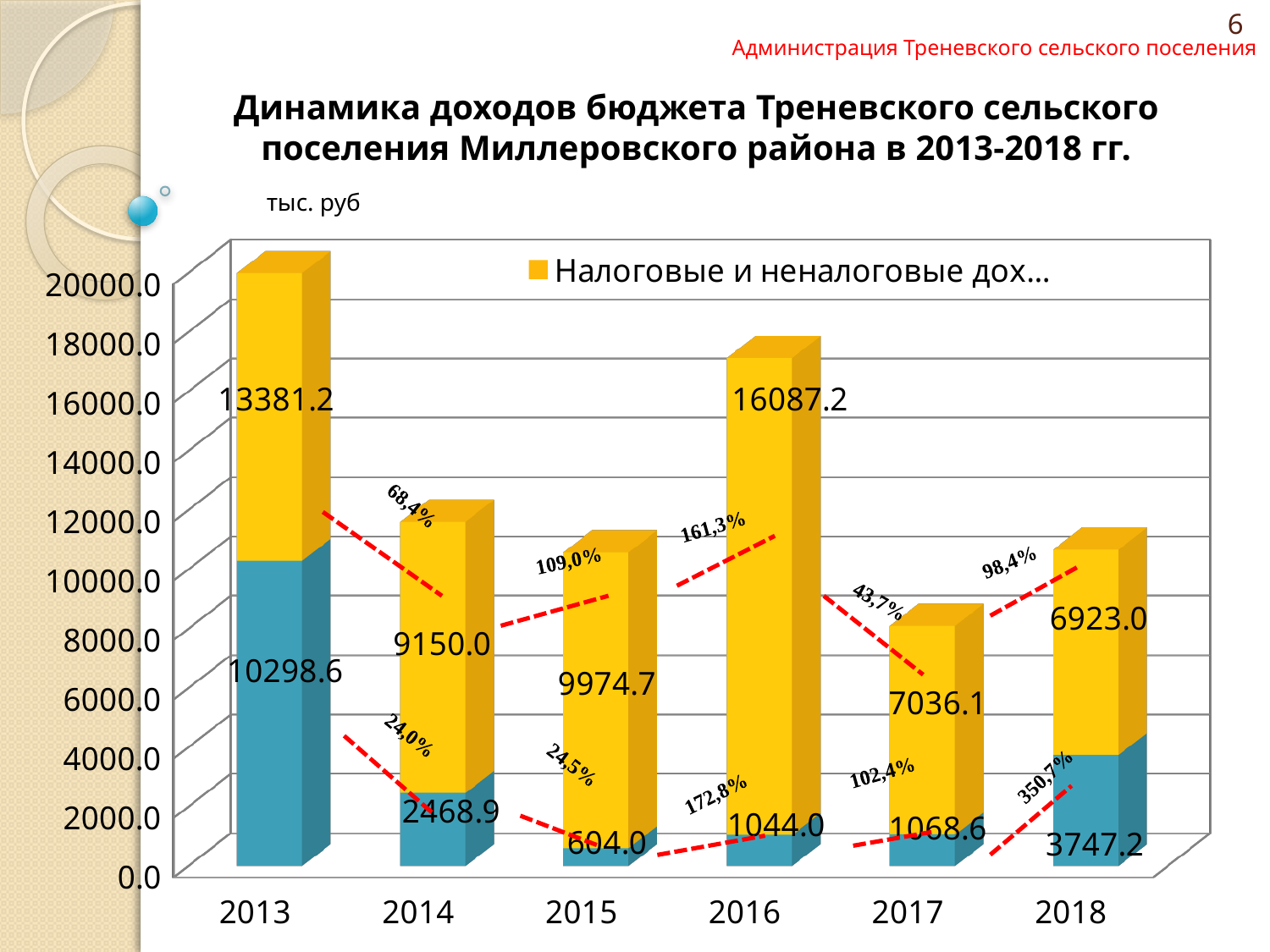
Which is larger: the yellow segment for 2014 or the yellow segment for 2015? 2015 What is the value of the yellow segment for 2017? 7036.1 What is the difference between the yellow segment values for 2016 and 2013? 2706.0 What unit is indicated above the chart's vertical axis? тыс. руб What is the value of the blue (lower) segment for 2013? 10298.6 What is the total height of the stacked bar for 2013 (blue plus yellow)? 23679.8 In which year is the yellow (Налоговые и неналоговые доходы) segment the largest? 2016 What is the value of the blue (lower) segment for 2018? 3747.2 How many years are shown on the x axis of the chart? 6 What type of chart is shown on the slide? stacked bar chart In which year is the blue (lower) segment the smallest? 2015 What is the value of the yellow (Налоговые и неналоговые доходы) segment for 2016? 16087.2